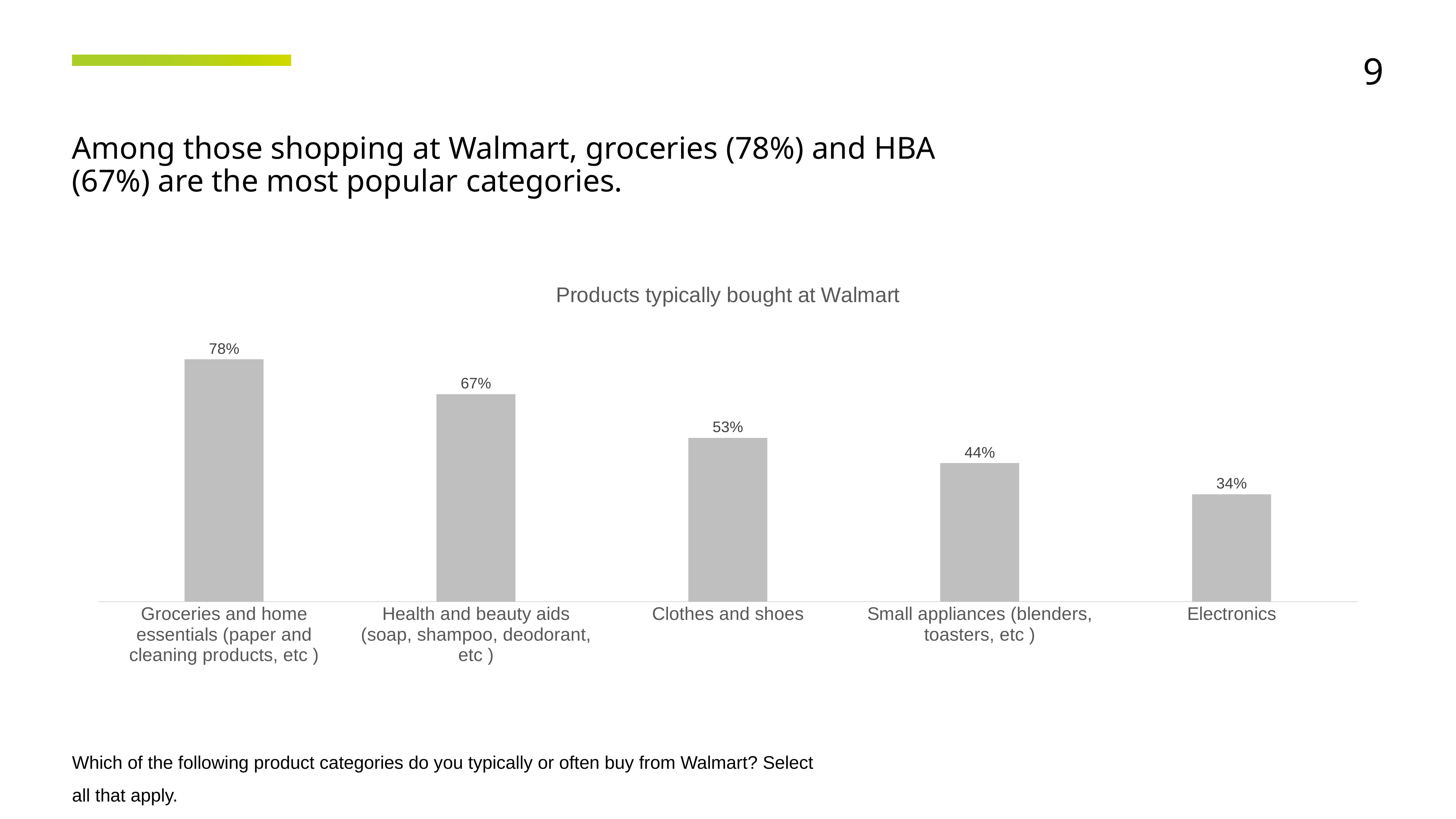
What is the difference between Health and beauty aids and Small appliances? 23 percentage points What is the title of the chart? Products typically bought at Walmart What percentage of Walmart shoppers typically buy Groceries and home essentials? 78% How many product categories are shown in the chart? 5 Which product category has the highest value? Groceries and home essentials What is the value for Electronics? 34% Which is larger, the value for Clothes and shoes or the value for Small appliances? Clothes and shoes What kind of chart is shown on the slide? Bar chart What is the difference between the values for Groceries and home essentials and Electronics? 44 percentage points What is the value shown for Health and beauty aids? 67% Which product category has the lowest value? Electronics What percentage is shown for Clothes and shoes? 53%